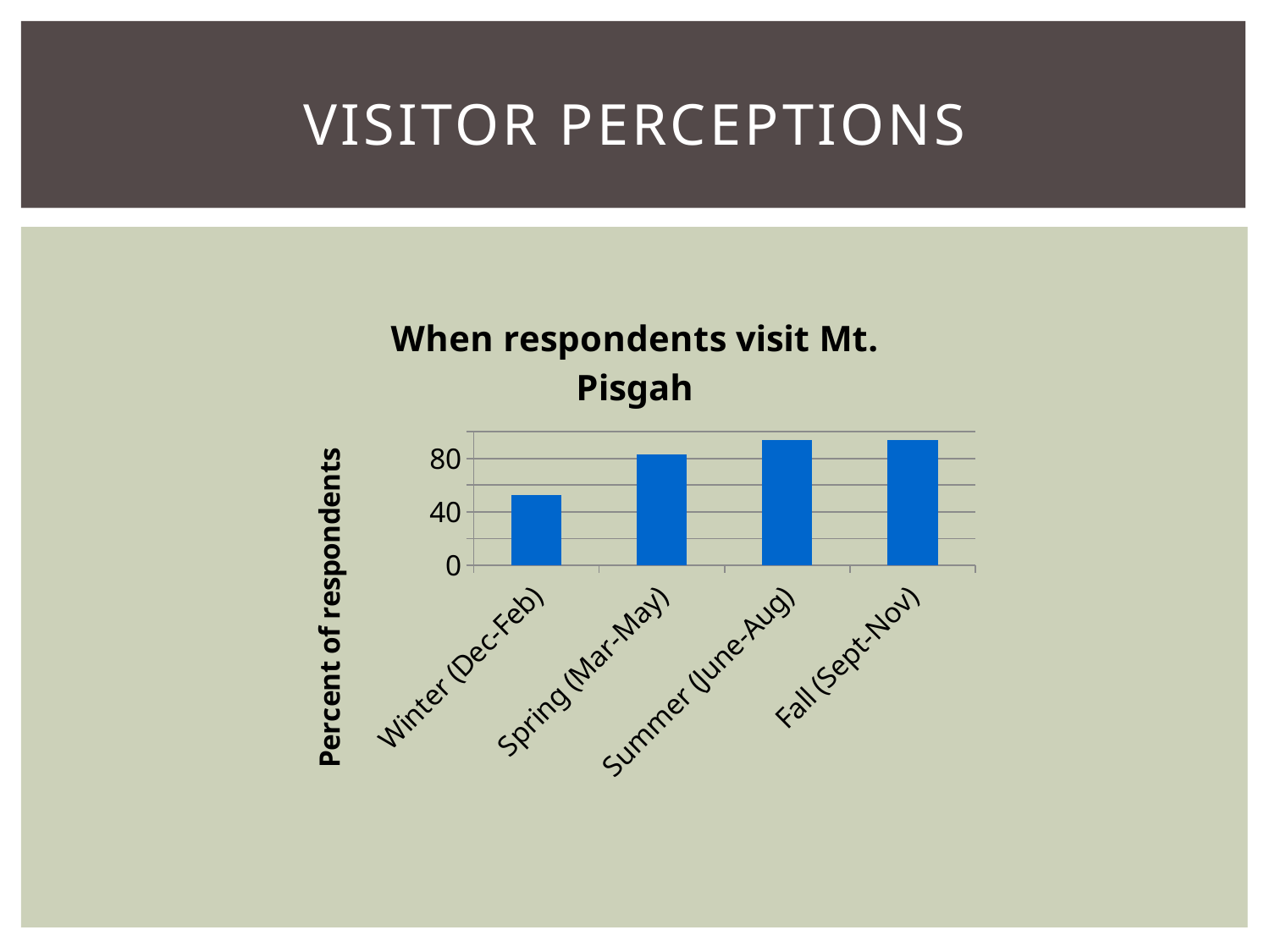
Is the value for Winter (Dec-Feb) greater or less than 80? less Is the value for Summer (June-Aug) greater or less than 80? greater Is the value for Winter (Dec-Feb) greater or less than 40? greater What is the label on the vertical axis of the chart? Percent of respondents Which is larger, the value for Spring (Mar-May) or the value for Winter (Dec-Feb)? Spring (Mar-May) What is the title of the chart? When respondents visit Mt. Pisgah What kind of chart is shown on the slide? bar chart How many seasons (categories) are shown on the x axis of the chart? 4 Do the values rise or fall from Winter (Dec-Feb) to Summer (June-Aug)? rise Which season has the lowest percent of respondents? Winter (Dec-Feb) Which is larger, the value for Fall (Sept-Nov) or the value for Spring (Mar-May)? Fall (Sept-Nov)